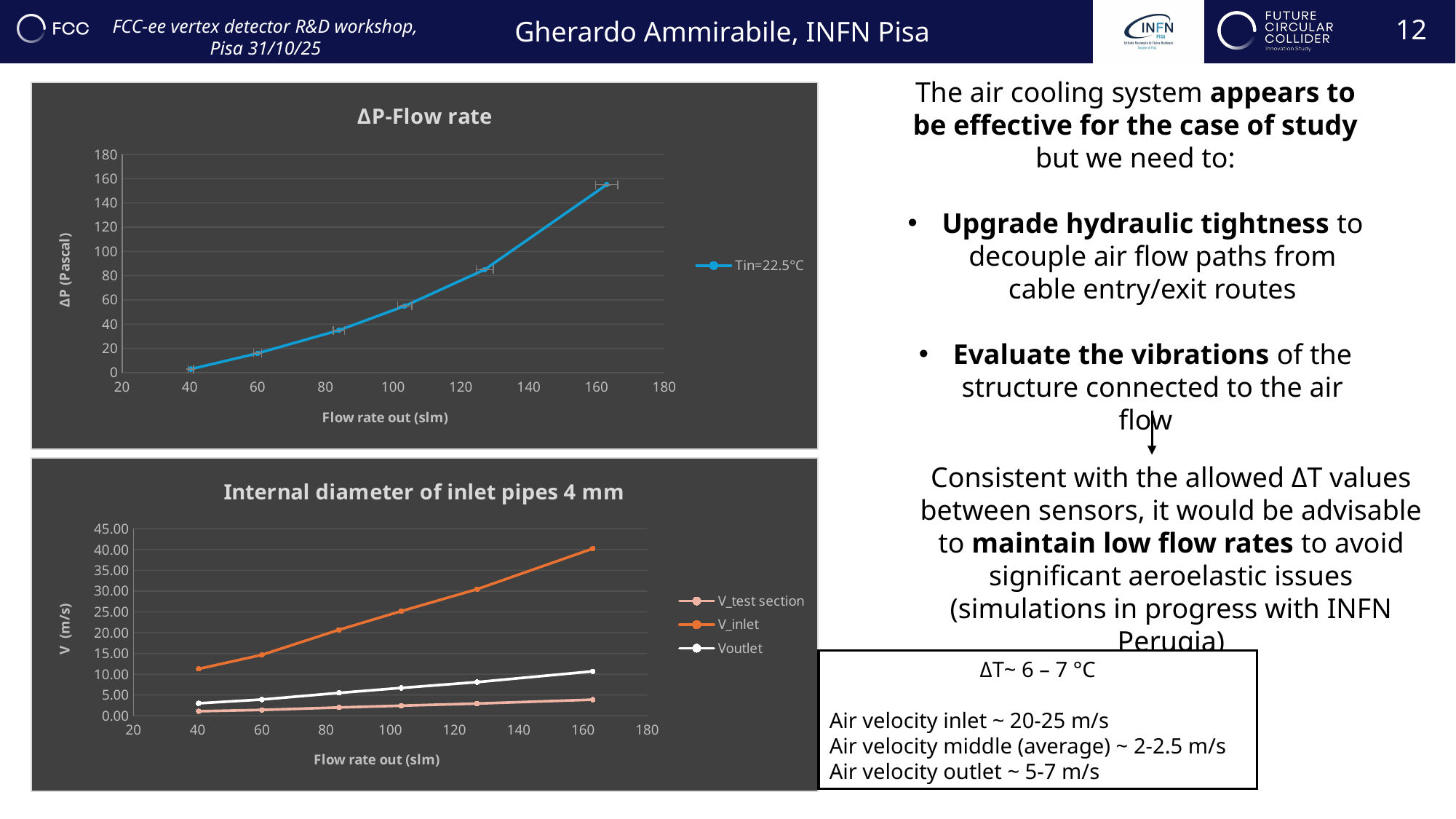
How many series does the legend of the 'ΔP-Flow rate' chart list? 1 What is the name of the series in the legend of the 'ΔP-Flow rate' chart? Tin=22.5°C In the 'ΔP-Flow rate' chart, is the ΔP value for the rightmost (highest flow rate) point greater or less than 140? greater In the 'Internal diameter of inlet pipes 4 mm' chart, which series has the highest velocity values? V_inlet How many series does the legend of the 'Internal diameter of inlet pipes 4 mm' chart list? 3 How many data points are plotted on the 'ΔP-Flow rate' chart? 6 In the 'ΔP-Flow rate' chart, is the ΔP value for the leftmost (lowest flow rate) point greater or less than 20? less In the 'ΔP-Flow rate' chart, does ΔP rise or fall as the flow rate increases? rises In the 'Internal diameter of inlet pipes 4 mm' chart, which series has the lowest velocity values? V_test section In the 'Internal diameter of inlet pipes 4 mm' chart, is the V_test section value at the rightmost (highest flow rate) point greater or less than 5.00? less What type of chart is the 'ΔP-Flow rate' chart? line chart